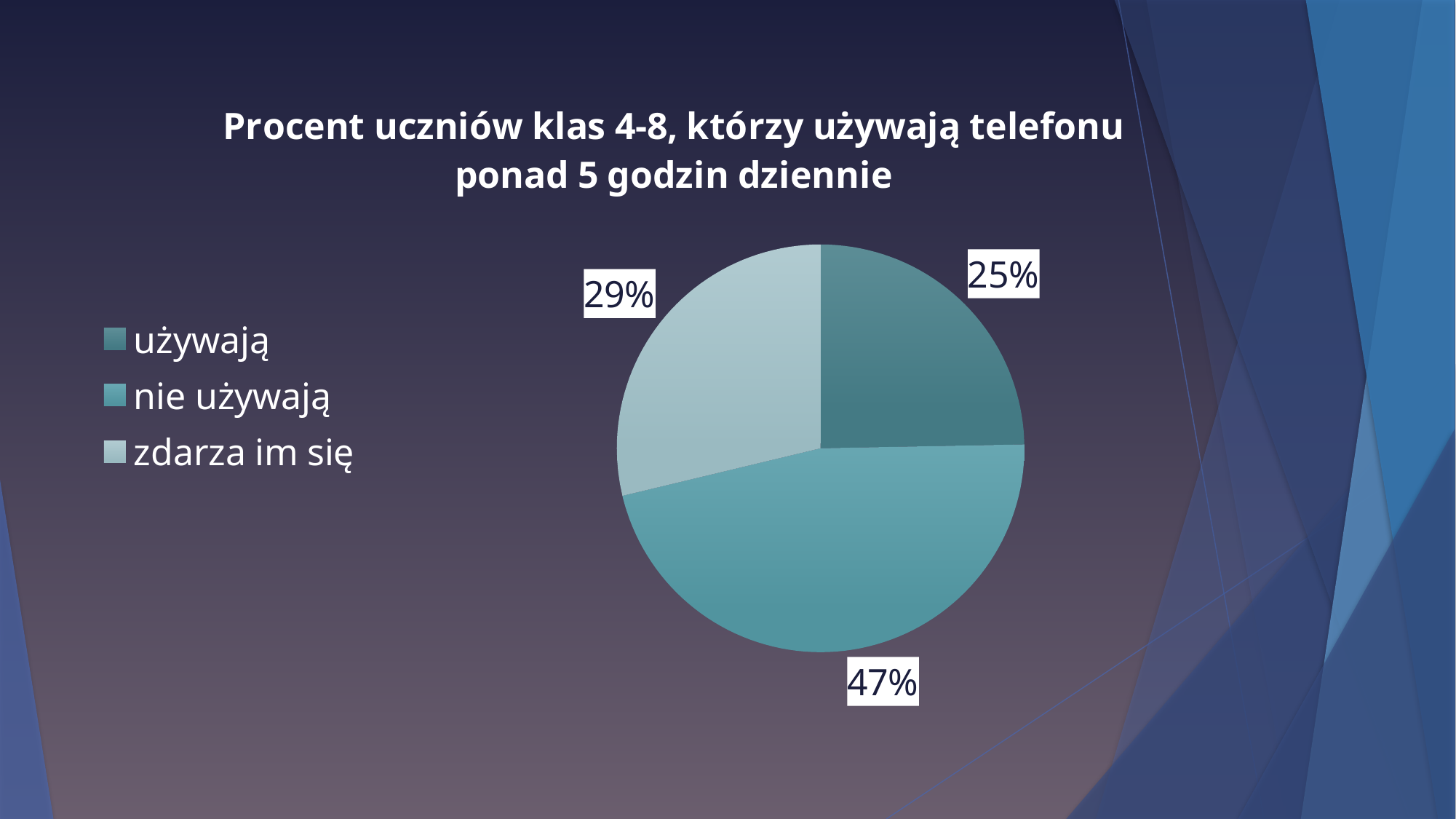
What is the difference in percentage points between 'nie używają' and 'używają'? 22 How many slices does the pie chart have? 3 Which is larger, the slice for 'zdarza im się' or the slice for 'używają'? zdarza im się What percentage of the pie is labelled for 'nie używają'? 47% What kind of chart is shown on the slide? pie chart What percentage of the pie is labelled for 'zdarza im się'? 29% Which legend entry is listed first? używają What percentage of the pie is labelled for 'używają'? 25% What is the difference in percentage points between 'zdarza im się' and 'używają'? 4 What is the title of the chart? Procent uczniów klas 4-8, którzy używają telefonu ponad 5 godzin dziennie Which category has the largest slice of the pie? nie używają Which category has the smallest slice of the pie? używają